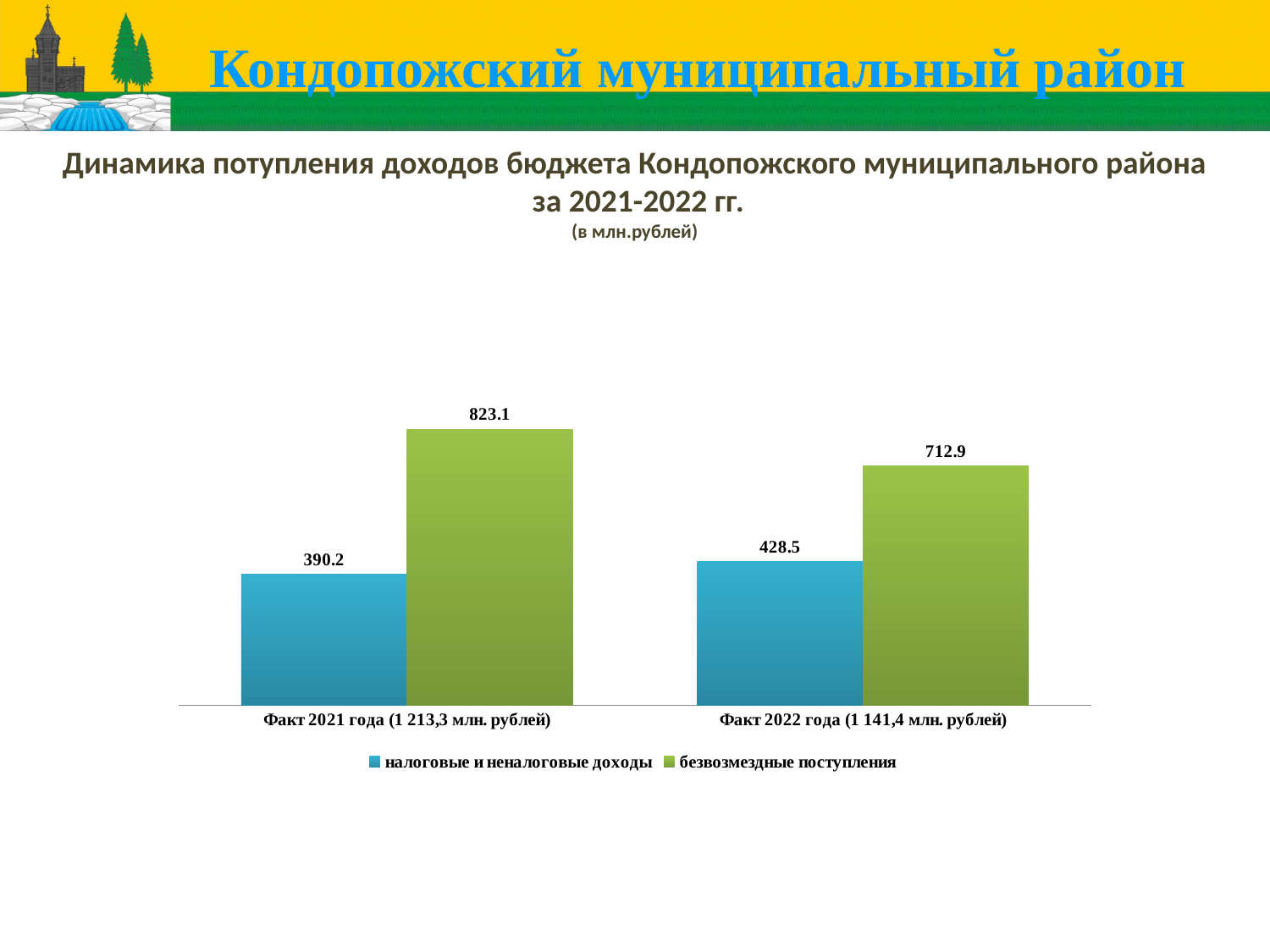
What kind of chart is shown on the slide? bar chart What is the difference between налоговые и неналоговые доходы in 2022 and in 2021? 38.3 How many categories are shown on the x axis? 2 Which bar has the lowest value on the chart? налоговые и неналоговые доходы, Факт 2021 года (390.2) What is the value of налоговые и неналоговые доходы for Факт 2022 года? 428.5 What is the value of безвозмездные поступления for Факт 2022 года? 712.9 What is the value of налоговые и неналоговые доходы for Факт 2021 года? 390.2 What is the difference between безвозмездные поступления in 2021 and in 2022? 110.2 What is the value of безвозмездные поступления for Факт 2021 года? 823.1 Which bar has the highest value on the chart? безвозмездные поступления, Факт 2021 года (823.1) Which is larger: налоговые и неналоговые доходы in 2021 or in 2022? 2022 How many series does the legend list? 2